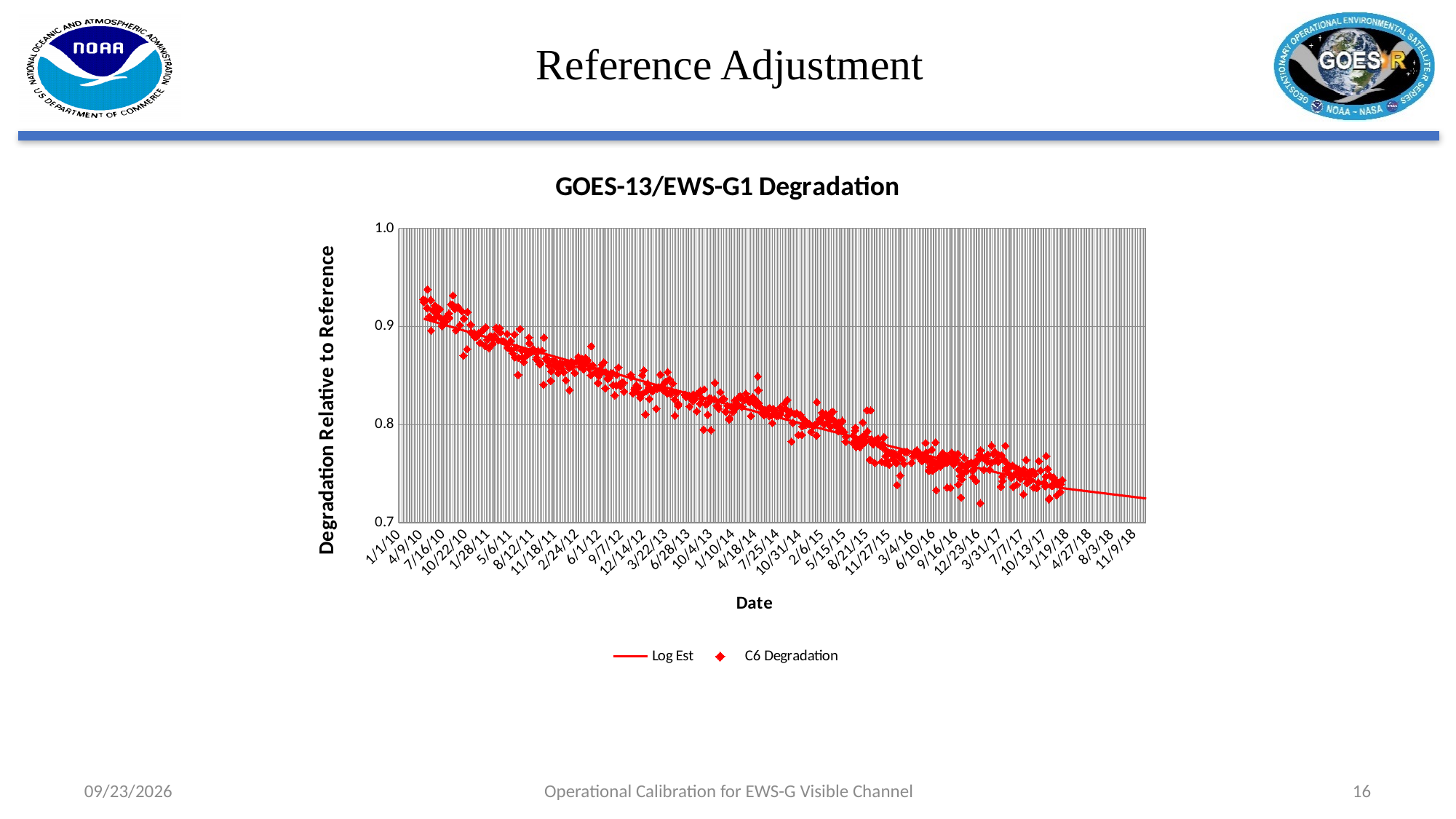
Are the C6 Degradation values near 2/24/12 greater or less than 0.9? less What kind of chart is shown on the slide? scatter chart Are the C6 Degradation values near 4/9/10 greater or less than 0.9? greater What is the maximum value shown on the y axis? 1.0 Do the C6 Degradation values rise or fall over time along the x axis? fall What are the two series named in the legend? Log Est and C6 Degradation Are the C6 Degradation values near 3/31/17 greater or less than 0.8? less What is the title of the chart? GOES-13/EWS-G1 Degradation How many series does the legend list? 2 Which is larger: the C6 Degradation value near 4/9/10 or near 1/19/18? 4/9/10